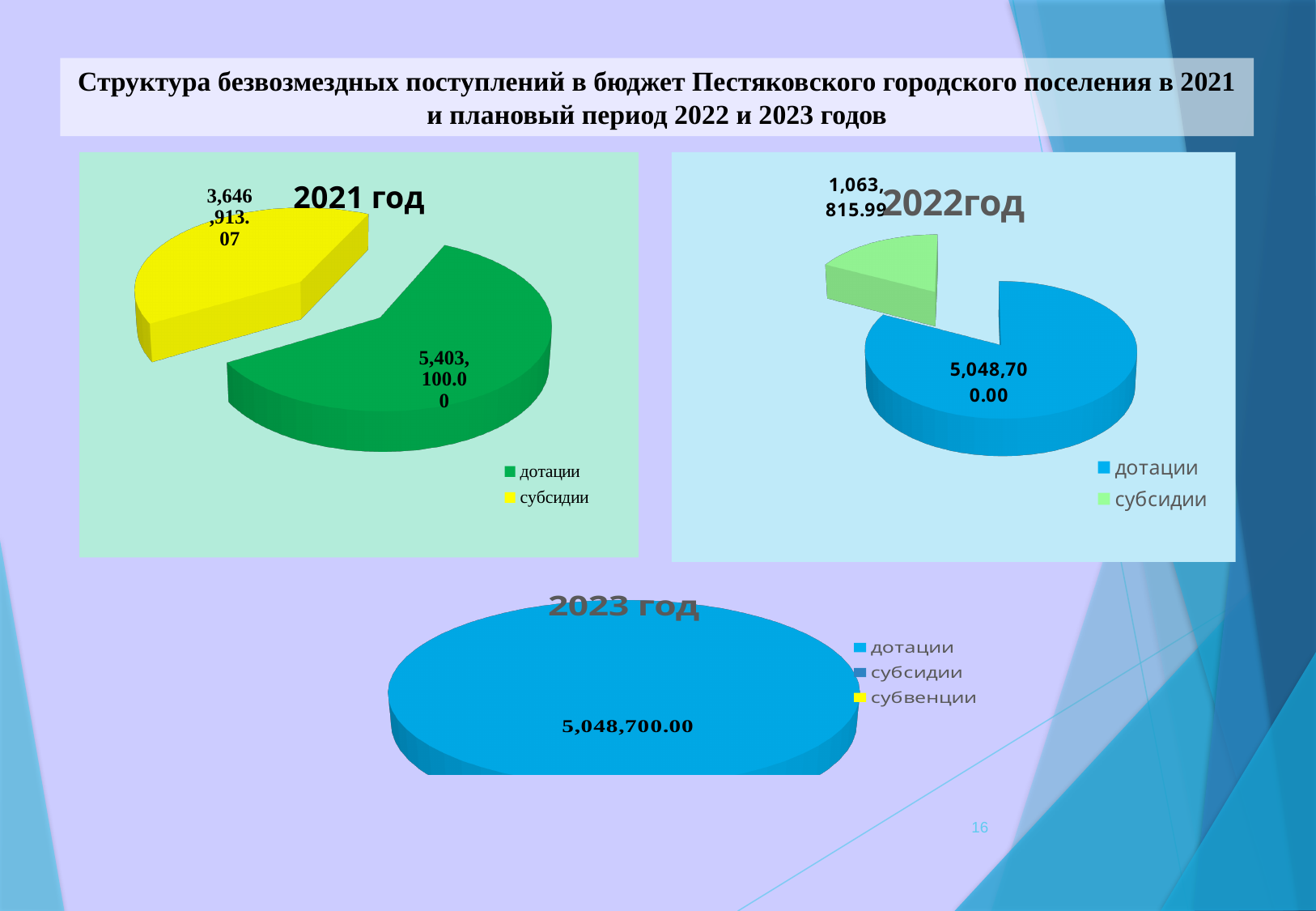
In the "2022год" chart, what is the value for субсидии? 1,063,815.99 Is the value for субсидии larger in the "2021 год" chart or in the "2022год" chart? 2021 год What kind of chart is the "2022год" chart? pie chart In the "2022год" chart, which category has the smallest slice? субсидии In the "2021 год" chart, what is the value for дотации? 5,403,100.00 How many entries does the legend of the "2023 год" chart list? 3 In the "2021 год" chart, what is the value for субсидии? 3,646,913.07 In the "2021 год" chart, what is the difference between дотации and субсидии? 1,756,186.93 In the "2022год" chart, what is the value for дотации? 5,048,700.00 In the "2022год" chart, what is the difference between дотации and субсидии? 3,984,884.01 In the "2021 год" chart, which category has the largest slice? дотации In the "2023 год" chart, what value is printed on the pie? 5,048,700.00